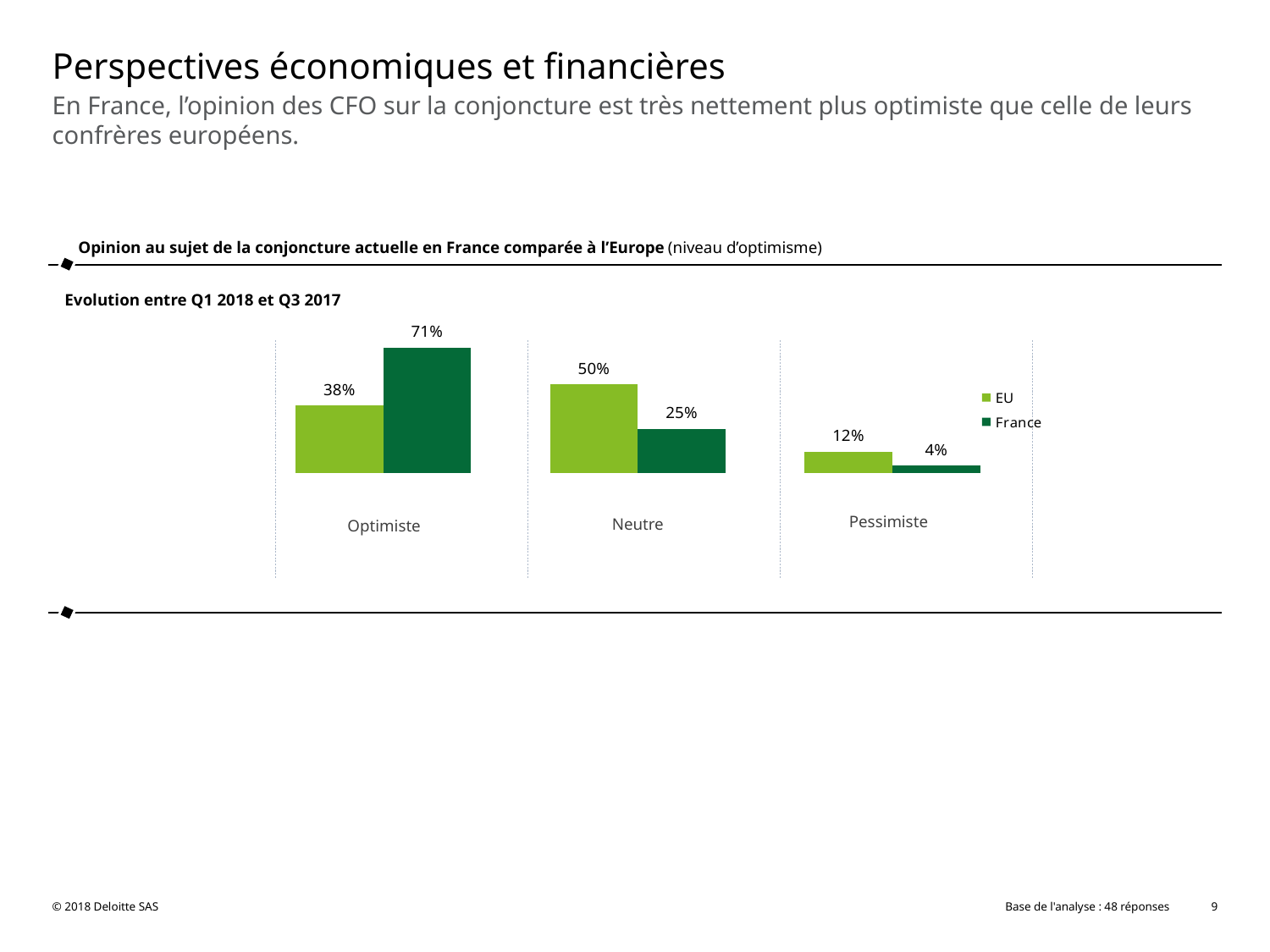
What is the difference between the France and EU values in the Optimiste category? 33% What is the value for France in the Pessimiste category? 4% Which category has the highest value for France? Optimiste What is the value for France in the Optimiste category? 71% How many series does the legend list? 2 What is the value for EU in the Optimiste category? 38% What kind of chart is shown on the slide? Bar chart What is the difference between the EU and France values in the Neutre category? 25% Which category has the lowest value for EU? Pessimiste What is the value for EU in the Neutre category? 50% How many categories are shown on the x axis? 3 Which is larger in the Pessimiste category, EU or France? EU